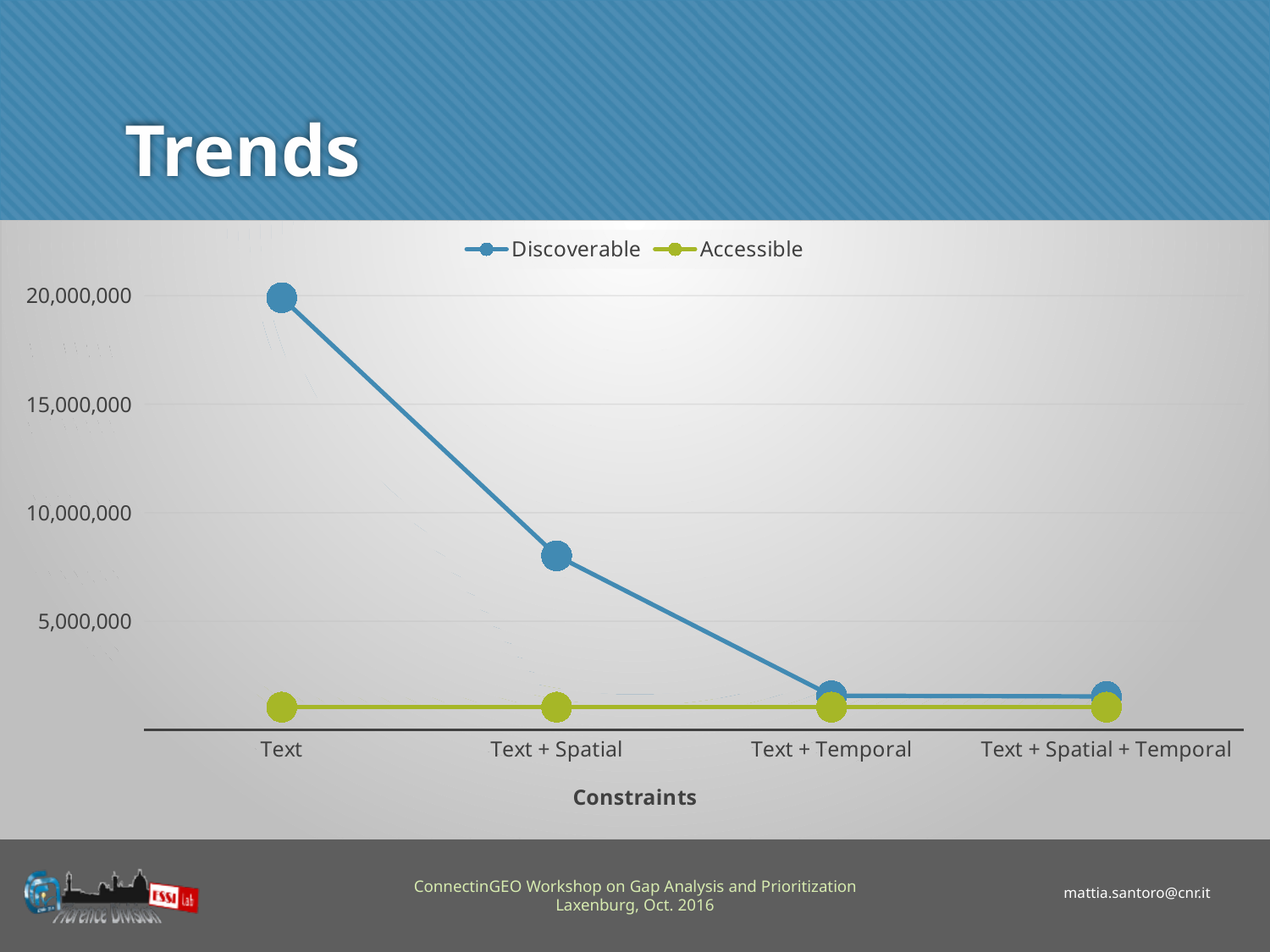
Is the Discoverable value for Text + Spatial greater or less than 10,000,000? less Does the Discoverable series rise or fall from Text to Text + Temporal? fall How many series does the legend list? 2 Is the Accessible value for Text greater or less than 5,000,000? less For the Discoverable series, which is larger: the value for Text or the value for Text + Spatial? Text What is the title of the x axis? Constraints What kind of chart is shown on the slide? line chart For the Text constraint, which series has the larger value, Discoverable or Accessible? Discoverable Is the Discoverable value for Text greater or less than 15,000,000? greater For which constraint is the Discoverable value highest? Text How many categories are shown on the x axis? 4